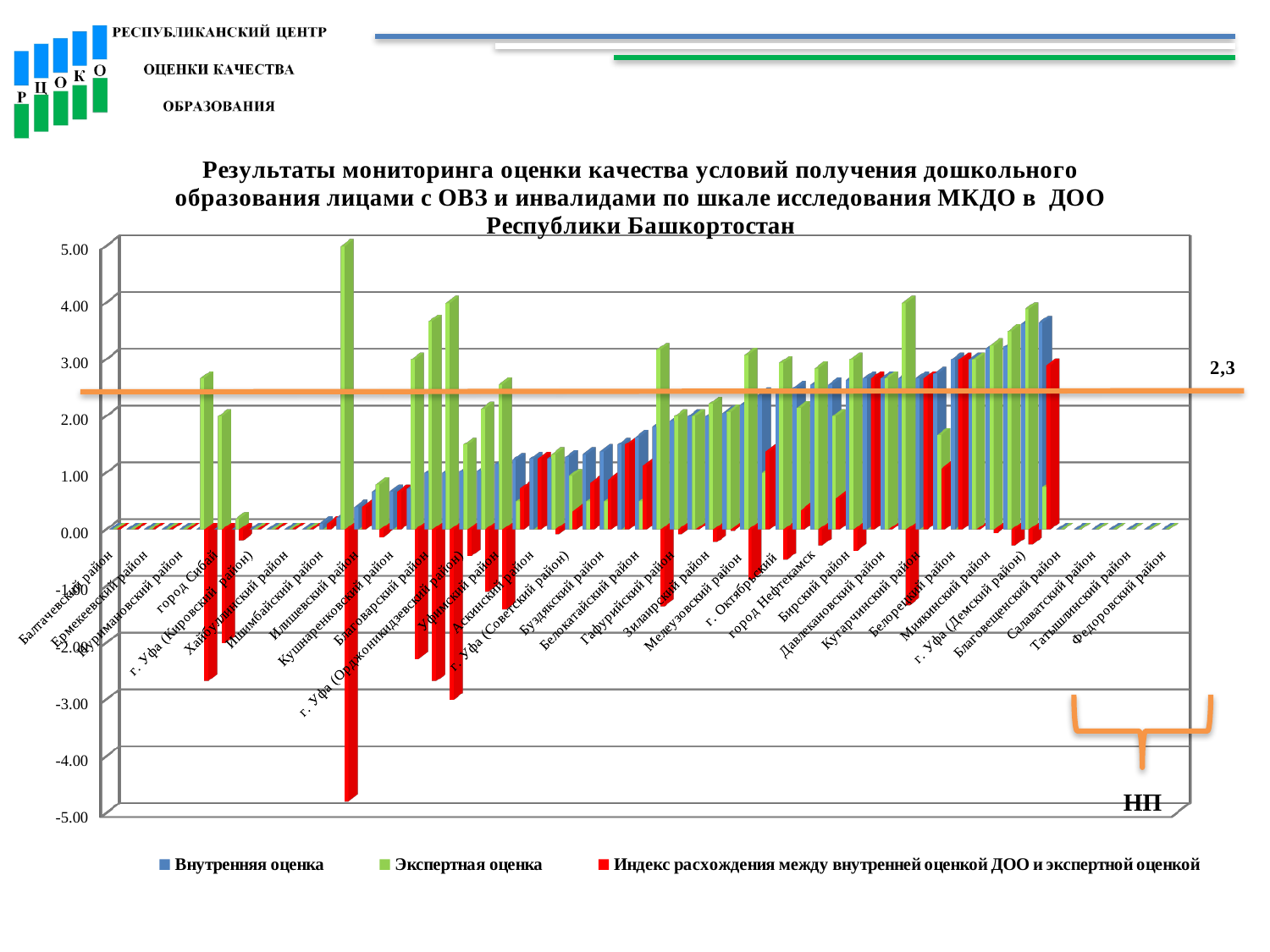
What value is marked by the orange horizontal line across the chart? 2,3 Is the 'Экспертная оценка' value for Балтачевский район greater or less than 1.00? less Is the lowest 'Индекс расхождения между внутренней оценкой ДОО и экспертной оценкой' bar greater or less than -4.00? less Is the tallest 'Экспертная оценка' bar greater or less than 4.00? greater What kind of chart is shown on the slide? bar chart Which colour represents the series 'Экспертная оценка' in the legend? green Do the 'Внутренняя оценка' values generally rise or fall from left to right along the x axis? rise What label is written under the bracket at the right end of the chart? НП How many series does the legend list? 3 What is the highest tick value shown on the vertical axis? 5.00